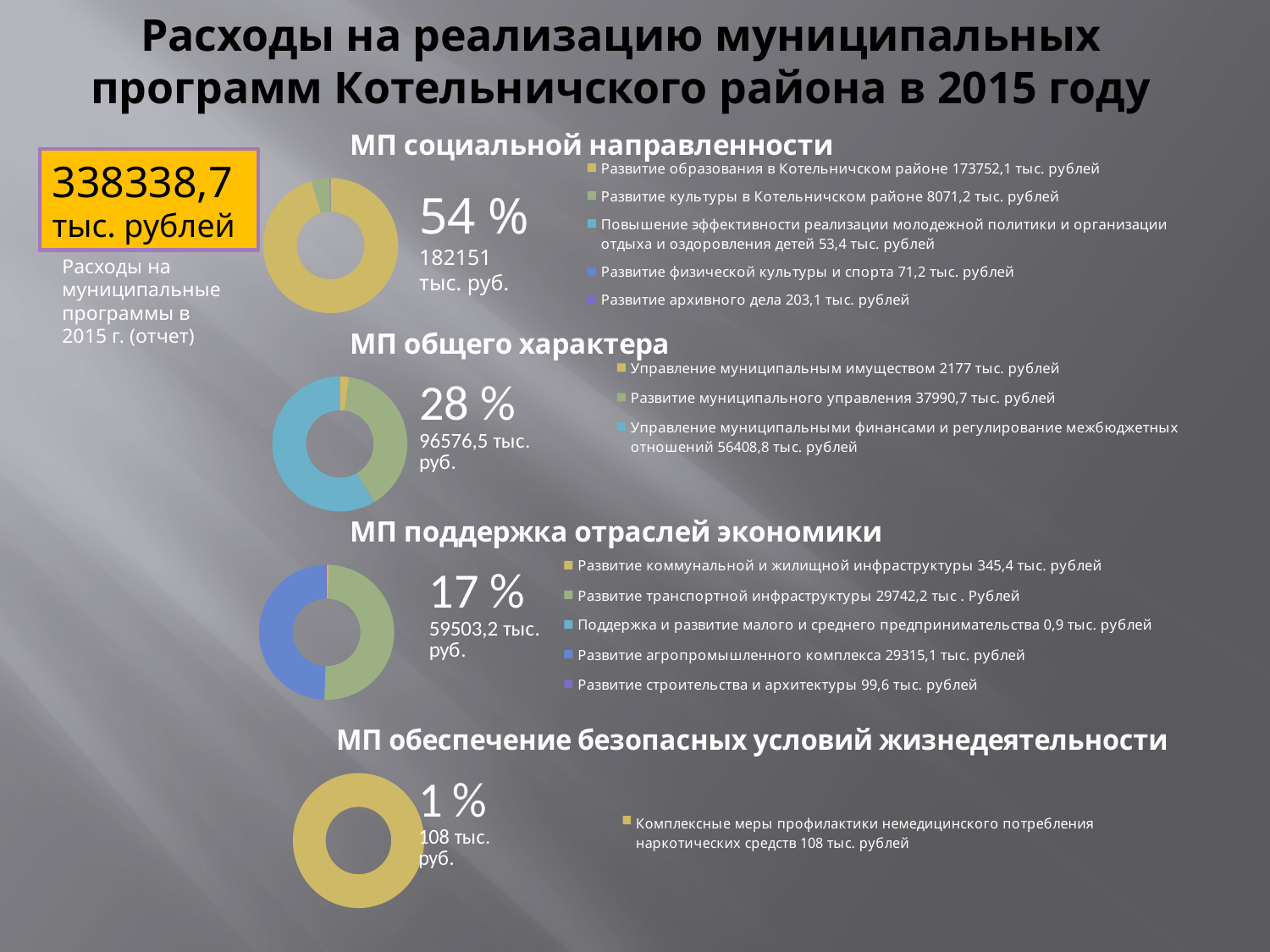
On the 'МП общего характера' chart, what is the difference between 'Развитие муниципального управления' and 'Управление муниципальным имуществом'? 35813,7 тыс. рублей On the 'МП поддержка отраслей экономики' chart, which is larger: 'Развитие транспортной инфраструктуры' or 'Развитие агропромышленного комплекса'? Развитие транспортной инфраструктуры How many categories does the legend of the 'МП социальной направленности' chart list? 5 On the 'МП социальной направленности' chart, what is the value for 'Развитие образования в Котельничском районе'? 173752,1 тыс. рублей What share of total expenditure is shown next to the 'МП социальной направленности' chart? 54 % What percentage is shown next to the 'МП обеспечение безопасных условий жизнедеятельности' chart? 1 % On the 'МП поддержка отраслей экономики' chart, what is the value for 'Поддержка и развитие малого и среднего предпринимательства'? 0,9 тыс. рублей What kind of chart is used for 'МП обеспечение безопасных условий жизнедеятельности'? doughnut chart On the 'МП социальной направленности' chart, which category has the lowest value? Повышение эффективности реализации молодежной политики и организации отдыха и оздоровления детей On the 'МП общего характера' chart, which category has the highest value? Управление муниципальными финансами и регулирование межбюджетных отношений What total amount is shown next to the 'МП поддержка отраслей экономики' chart? 59503,2 тыс. руб. On the 'МП общего характера' chart, what is the value for 'Управление муниципальными финансами и регулирование межбюджетных отношений'? 56408,8 тыс. рублей